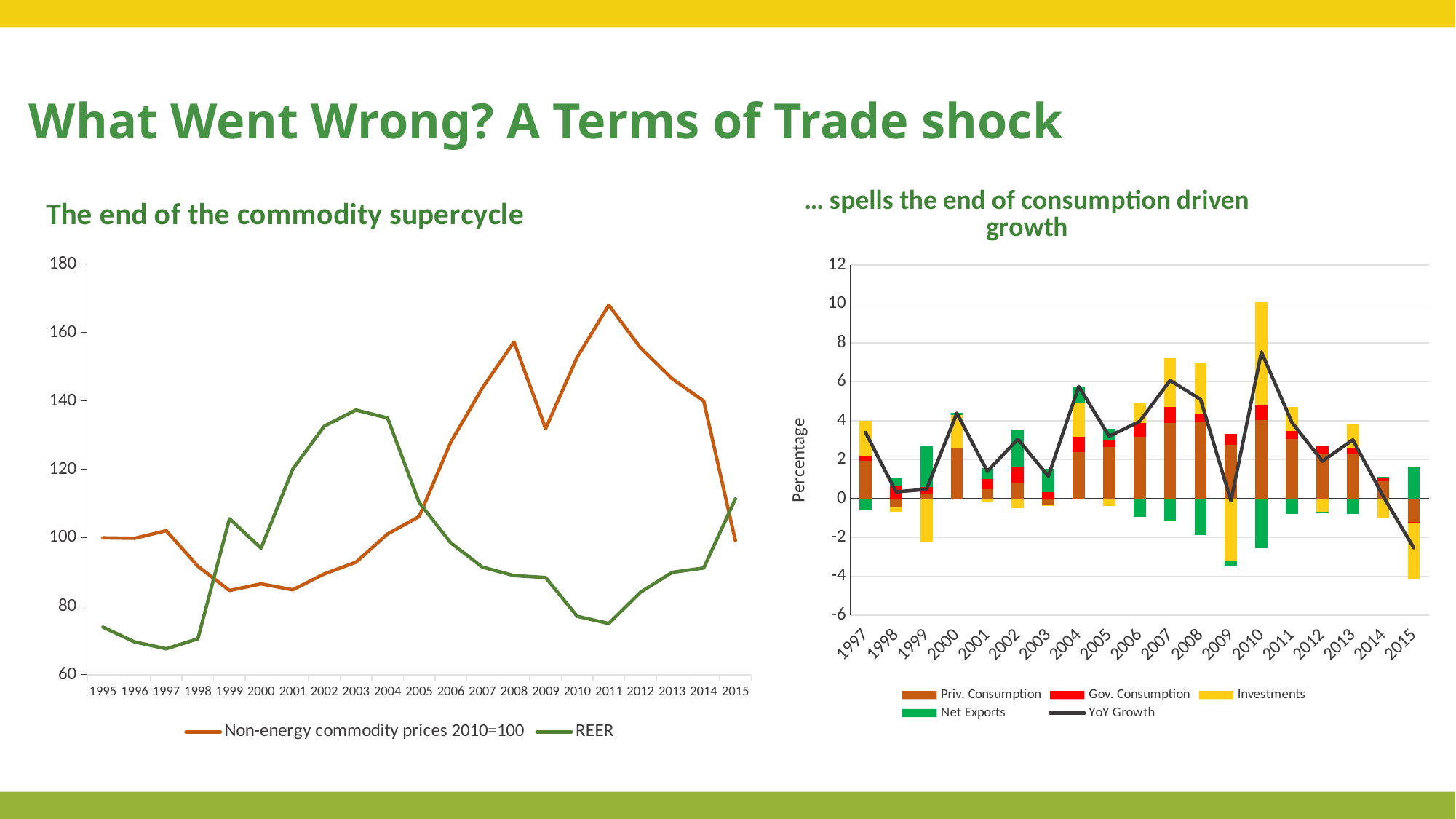
In 'The end of the commodity supercycle', which series has the higher value in 2003, Non-energy commodity prices or REER? REER In 'The end of the commodity supercycle', do Non-energy commodity prices rise or fall from 2011 to 2015? Fall In '… spells the end of consumption driven growth', in which year is YoY Growth highest? 2010 How many series does the legend of '… spells the end of consumption driven growth' list? 5 In '… spells the end of consumption driven growth', is the YoY Growth value for 2015 greater or less than -2? less In 'The end of the commodity supercycle', is the value of Non-energy commodity prices in 2011 greater or less than 160? greater How many series does the legend of 'The end of the commodity supercycle' list? 2 How many years are shown on the x axis of '… spells the end of consumption driven growth'? 19 What kind of chart is 'The end of the commodity supercycle'? Line chart In 'The end of the commodity supercycle', in which year do Non-energy commodity prices reach their highest value? 2011 In 'The end of the commodity supercycle', is the REER value in 1997 greater or less than 80? less How many years are plotted on the x axis of 'The end of the commodity supercycle'? 21